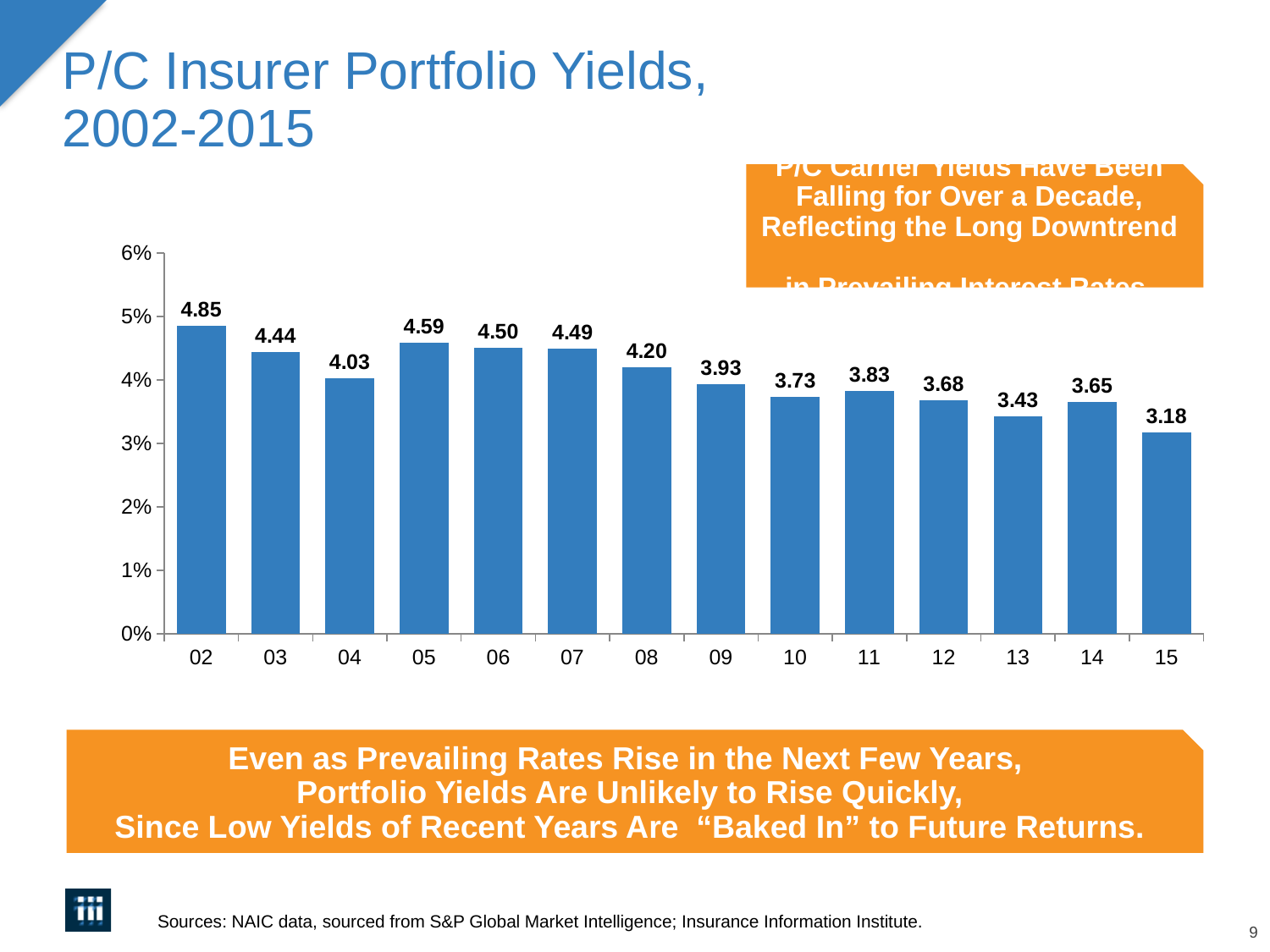
What is the title of the slide's chart? P/C Insurer Portfolio Yields, 2002-2015 What is the value shown for 09? 3.93 Is the value for 13 greater or less than 4%? less Which year has the lowest portfolio yield? 15 Which year has the highest portfolio yield? 02 What is the portfolio yield value shown for 02? 4.85 Do the values generally rise or fall from 02 to 15? fall What kind of chart is shown on the slide? bar chart Which is larger, the value for 11 or the value for 10? 11 What is the portfolio yield value shown for 15? 3.18 How many years are shown on the x axis? 14 What is the difference between the values for 02 and 15? 1.67